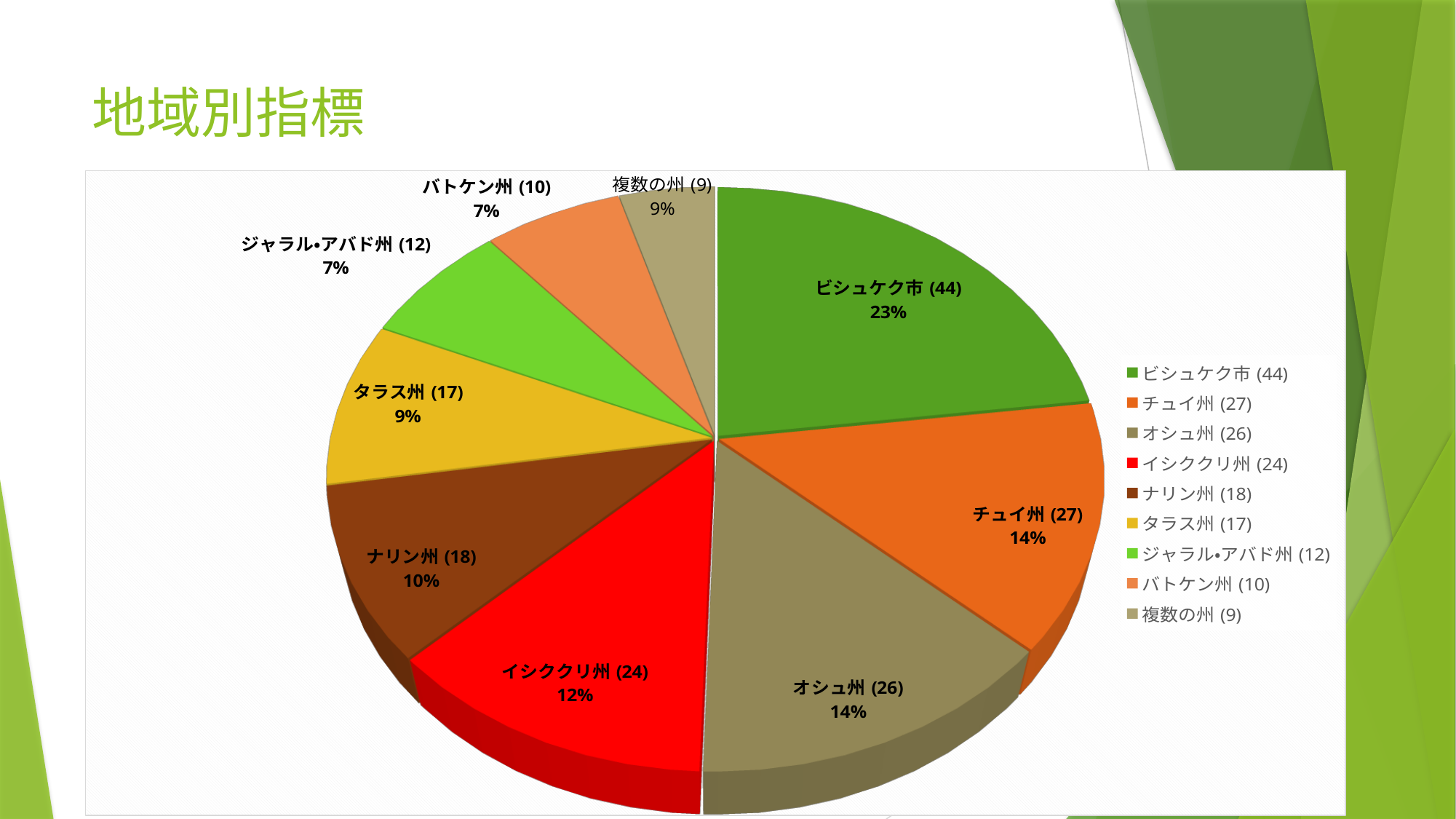
Which category has the smallest slice of the pie? 複数の州 (9) How many slices does the pie chart have? 9 Which is larger, the value for タラス州 or the value for ジャラル・アバド州? タラス州 What percentage share of the pie does イシククリ州 have? 12% What is the value shown for ナリン州? 18 Which category has the largest slice of the pie? ビシュケク市 (44) What percentage share of the pie does ビシュケク市 have? 23% What is the title of the slide containing the pie chart? 地域別指標 How many entries does the legend list? 9 What is the difference between the values for チュイ州 and バトケン州? 17 What is the value shown for ビシュケク市? 44 What kind of chart is shown on the slide? pie chart